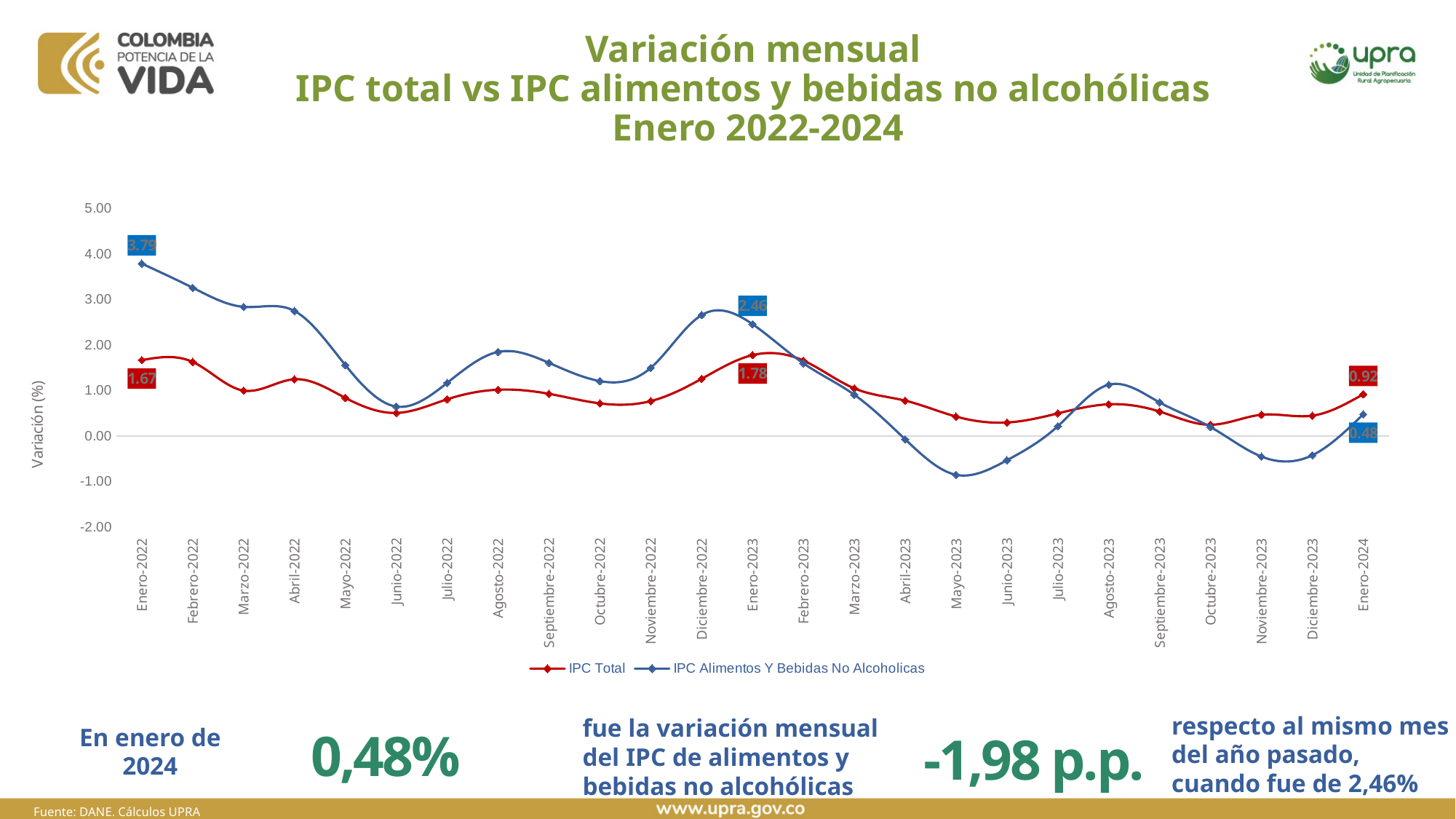
What is the value of IPC Alimentos Y Bebidas No Alcoholicas for Enero-2022? 3.79 What is the value of IPC Alimentos Y Bebidas No Alcoholicas for Enero-2023? 2.46 What is the difference between IPC Alimentos Y Bebidas No Alcoholicas and IPC Total in Enero-2022? 2.12 How many months are plotted on the x axis? 25 What is the value of IPC Total for Enero-2022? 1.67 In which month does IPC Alimentos Y Bebidas No Alcoholicas reach its highest value? Enero-2022 Which series has the higher value in Enero-2024, IPC Total or IPC Alimentos Y Bebidas No Alcoholicas? IPC Total How many series does the legend list? 2 What is the value of IPC Total for Enero-2024? 0.92 Is the value of IPC Alimentos Y Bebidas No Alcoholicas for Mayo-2023 greater or less than 0.00? less What kind of chart is shown on the slide? line chart What is the value of IPC Alimentos Y Bebidas No Alcoholicas for Enero-2024? 0.48